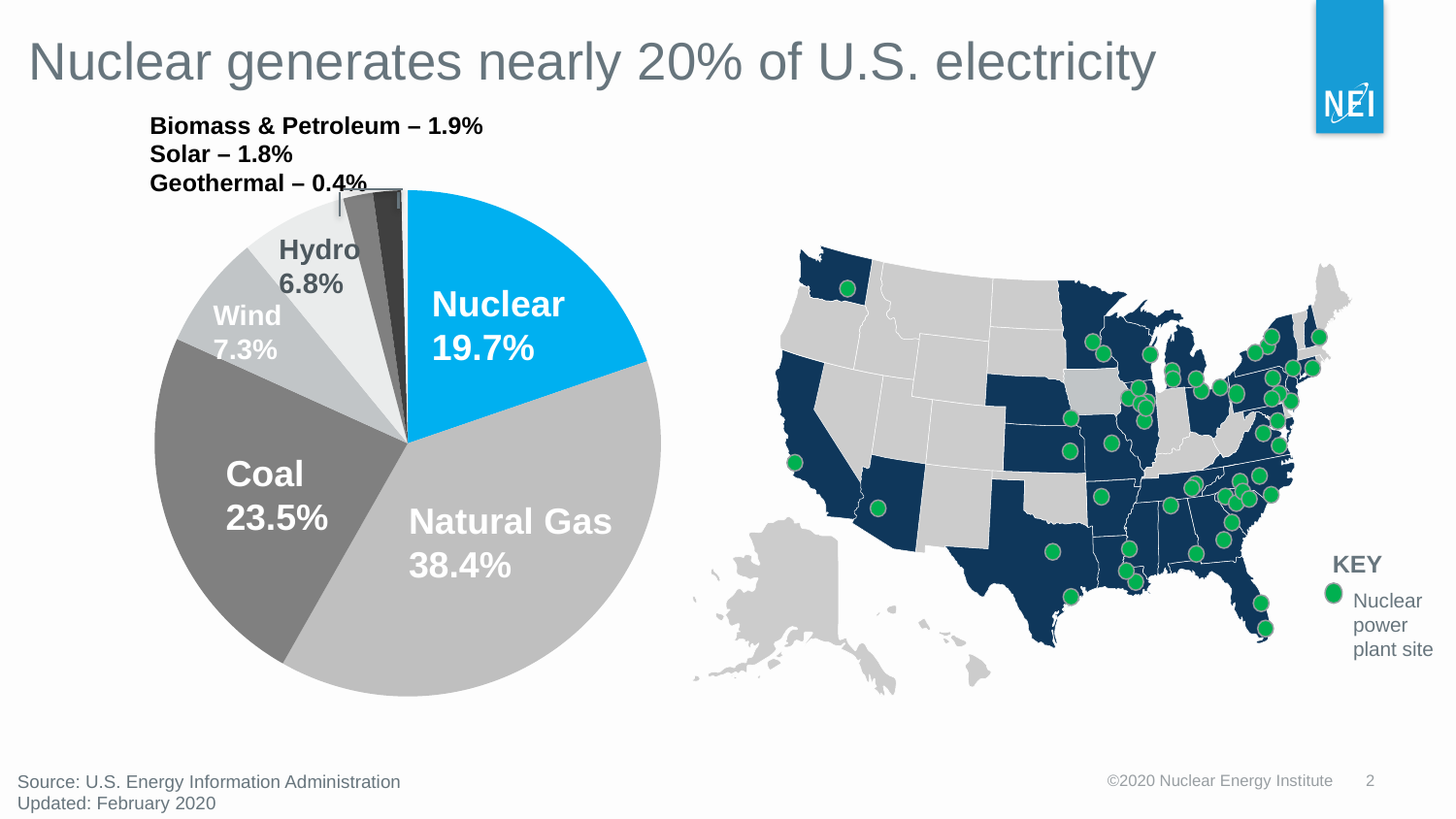
What percentage does the pie chart show for Geothermal? 0.4% How many energy sources are shown in the pie chart? 8 What is the difference in percentage points between Natural Gas and Nuclear in the pie chart? 18.7 Which energy source has the smallest slice in the pie chart? Geothermal What share of U.S. electricity does the pie chart show for Nuclear? 19.7% Which is larger in the pie chart, Coal or Nuclear? Coal What percentage does the pie chart show for Natural Gas? 38.4% What percentage does the pie chart show for Coal? 23.5% What type of chart is used to show the electricity generation mix? Pie chart Which energy source has the largest slice in the pie chart? Natural Gas What colour is the Nuclear slice in the pie chart? Blue What percentage does the pie chart show for Wind? 7.3%